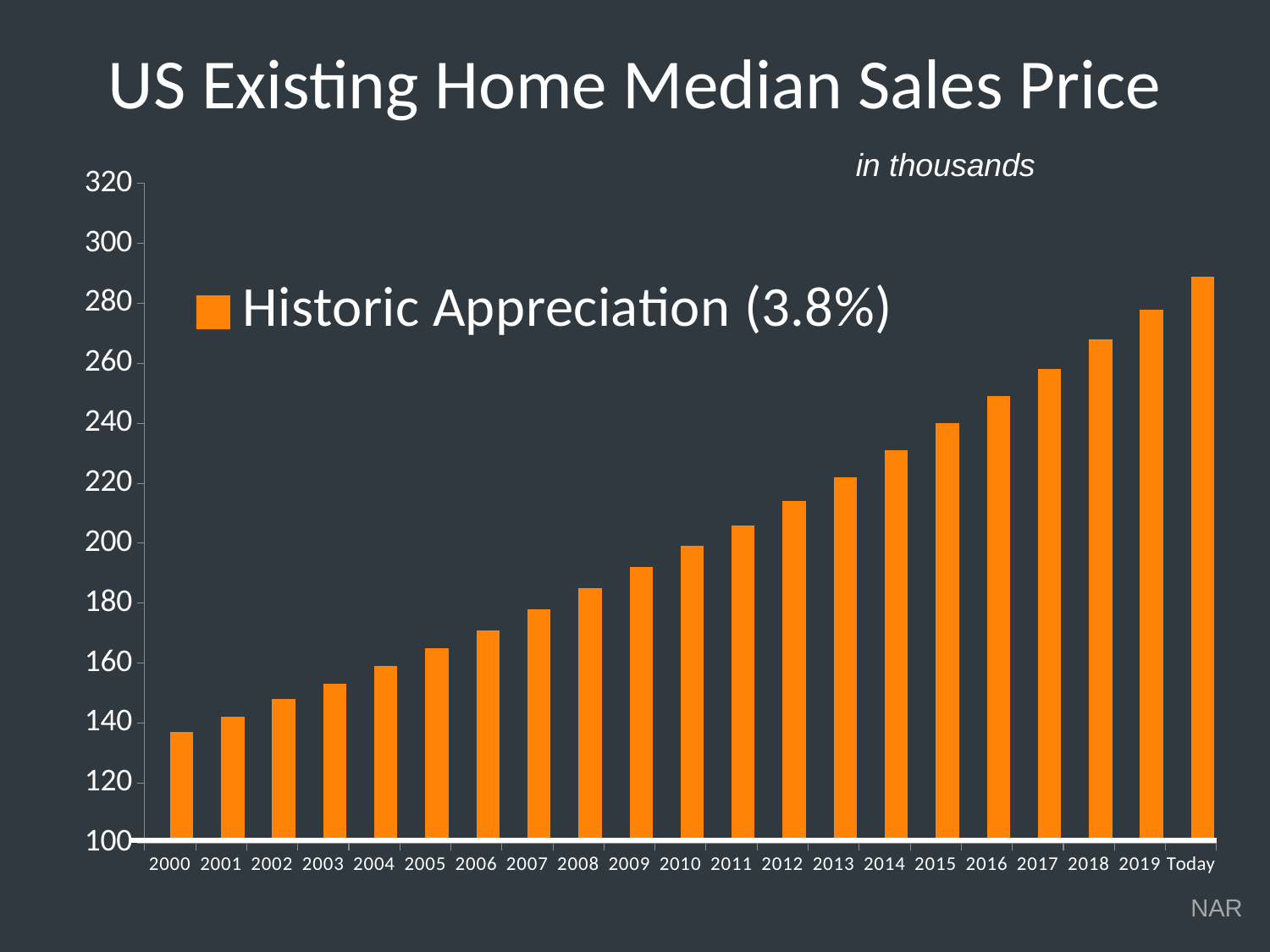
Is the value for 2012 greater or less than 200? greater How many bars (categories) are plotted on the chart? 21 What unit note is shown above the chart? in thousands Which category has the highest median sales price? Today Is the value for 2000 greater or less than 140? less Which is larger, the value for 2005 or the value for 2013? 2013 What is the legend entry for the series shown? Historic Appreciation (3.8%) Do the values rise or fall from 2000 to Today? rise Which year has the lowest median sales price? 2000 What kind of chart is shown on the slide? bar chart Is the value for Today greater or less than 280? greater How many series does the legend list? 1